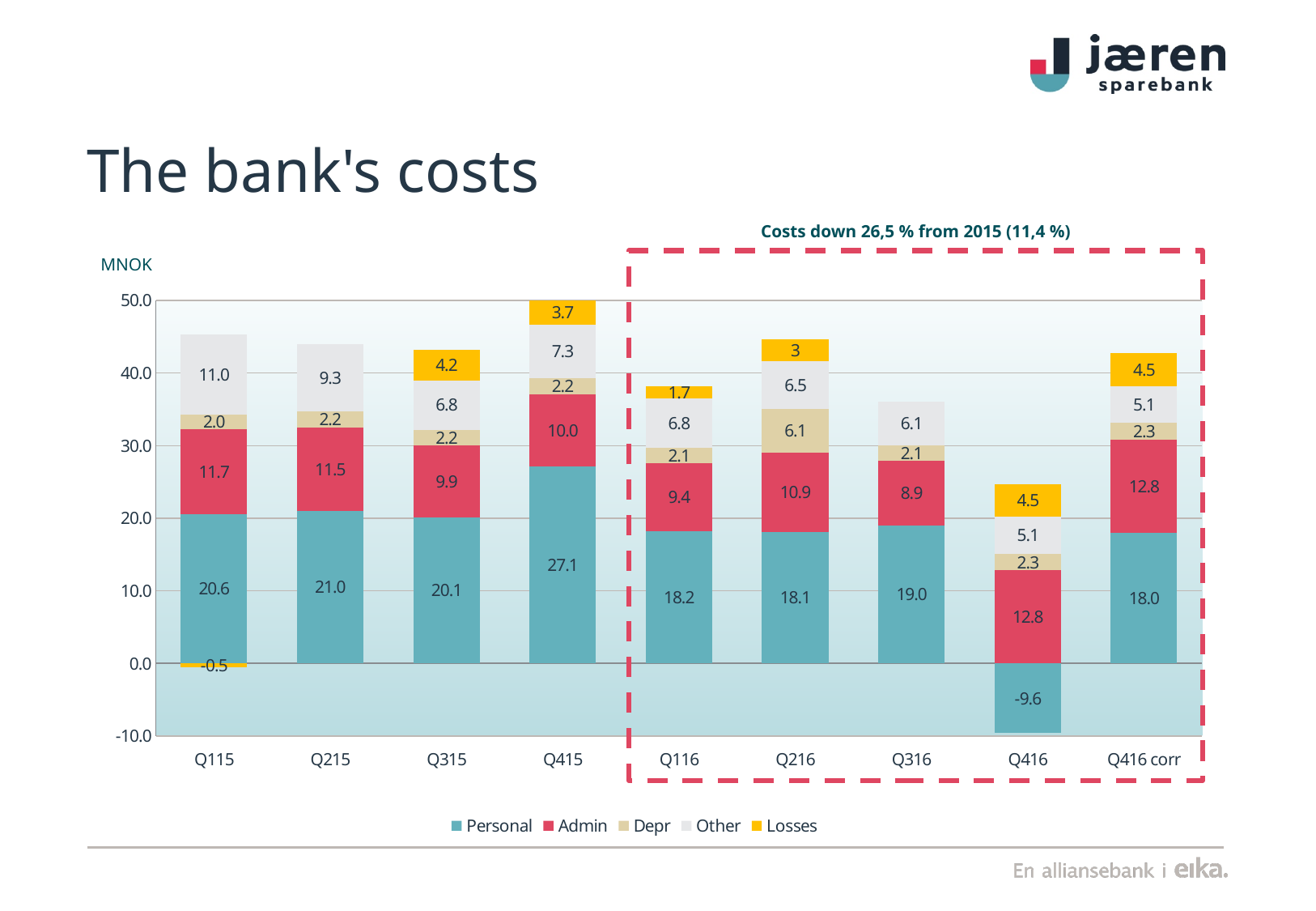
What unit is shown above the y axis? MNOK What is the total of the stacked bar for Q116? 38.2 How many series does the legend list? 5 Which is larger, the Admin value for Q315 or the Admin value for Q316? Q315 What is the Admin value for Q216? 10.9 What is the Personal cost value for Q415? 27.1 What is the Losses value for Q116? 1.7 Which quarter has the highest Personal cost? Q415 What type of chart is shown on the slide? stacked bar chart How many quarters (categories) are shown on the x axis? 9 Which quarter has the highest Other value? Q115 What is the difference between the Personal value for Q115 and the Personal value for Q116? 2.4